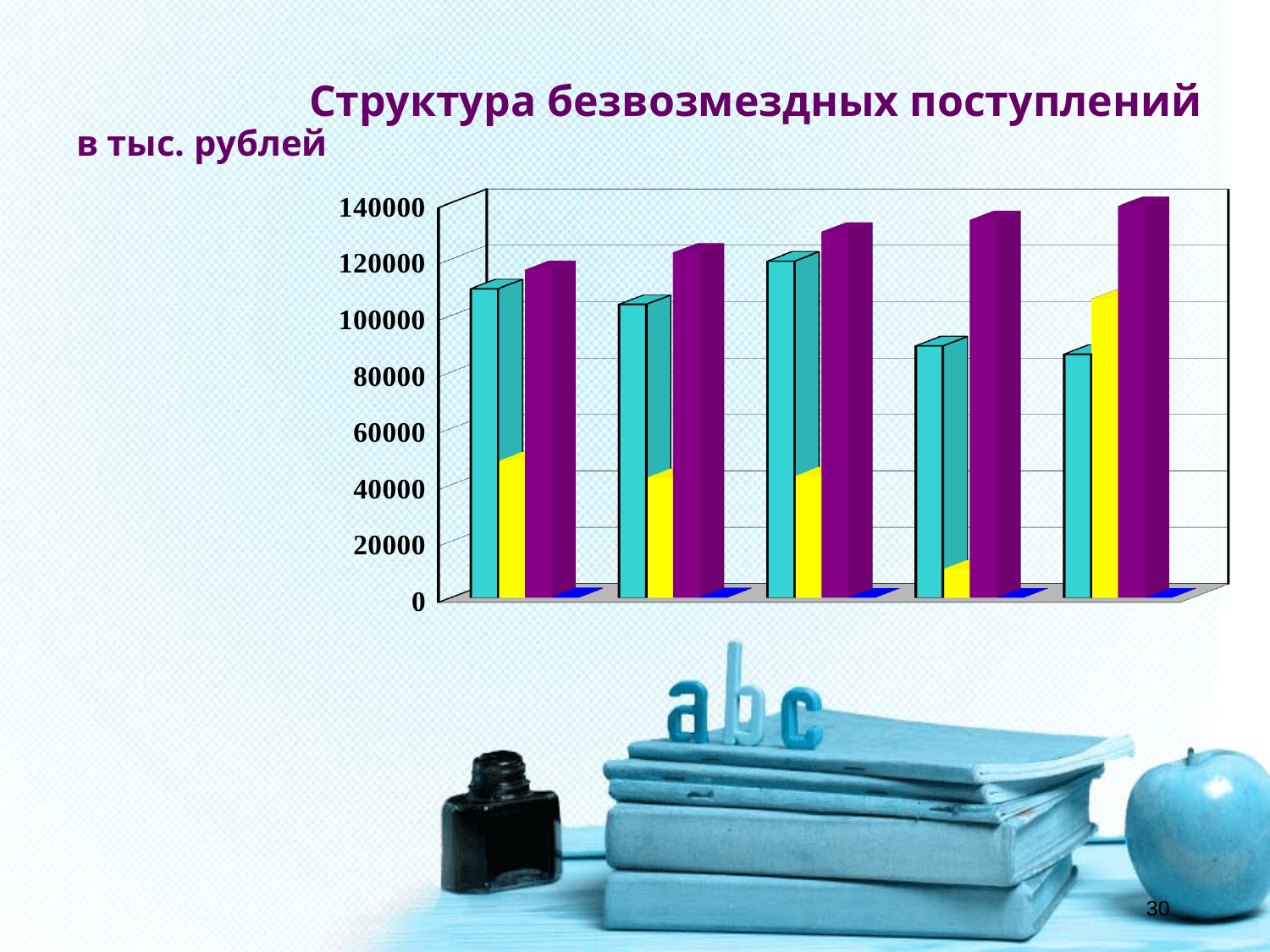
In which group from the left is the purple bar the tallest? the fifth group What is the title of the chart on the slide? Структура безвозмездных поступлений How many groups of bars are plotted along the x axis? 5 Is the yellow bar in the fourth group from the left greater or less than 20000? less Is the purple bar in the fifth group from the left greater or less than 120000? greater What kind of chart is shown on the slide? bar chart In the fifth group from the left, which is taller: the cyan bar or the yellow bar? the yellow bar Is the purple bar in the first group from the left greater or less than 100000? greater Do the purple bars rise or fall from left to right across the groups? rise In what units are the values on the chart given, according to the slide? в тыс. рублей